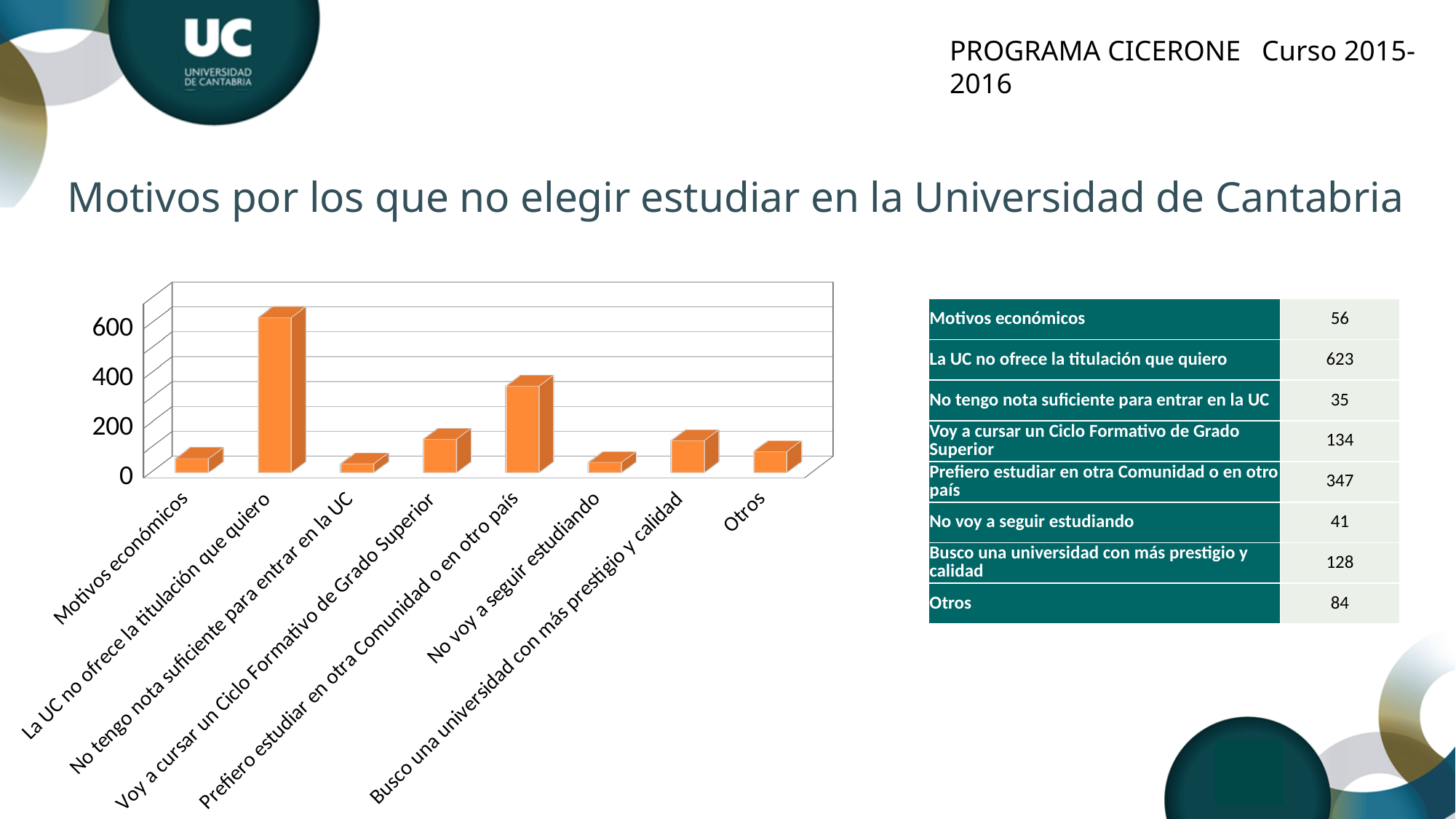
What is the value for 'Otros'? 84 How many categories does the bar chart show? 8 What is the value for 'La UC no ofrece la titulación que quiero'? 623 Which category has the lowest value in the chart? No tengo nota suficiente para entrar en la UC Which is larger, the value for 'Voy a cursar un Ciclo Formativo de Grado Superior' or the value for 'Busco una universidad con más prestigio y calidad'? Voy a cursar un Ciclo Formativo de Grado Superior What is the value for 'Prefiero estudiar en otra Comunidad o en otro país'? 347 Is the value for 'Prefiero estudiar en otra Comunidad o en otro país' greater or less than 200? greater What is the title of the slide above the chart? Motivos por los que no elegir estudiar en la Universidad de Cantabria Is the value for 'Motivos económicos' greater or less than 200? less What is the difference between the values for 'La UC no ofrece la titulación que quiero' and 'Prefiero estudiar en otra Comunidad o en otro país'? 276 Which category has the highest value in the chart? La UC no ofrece la titulación que quiero What kind of chart is shown on the slide? bar chart